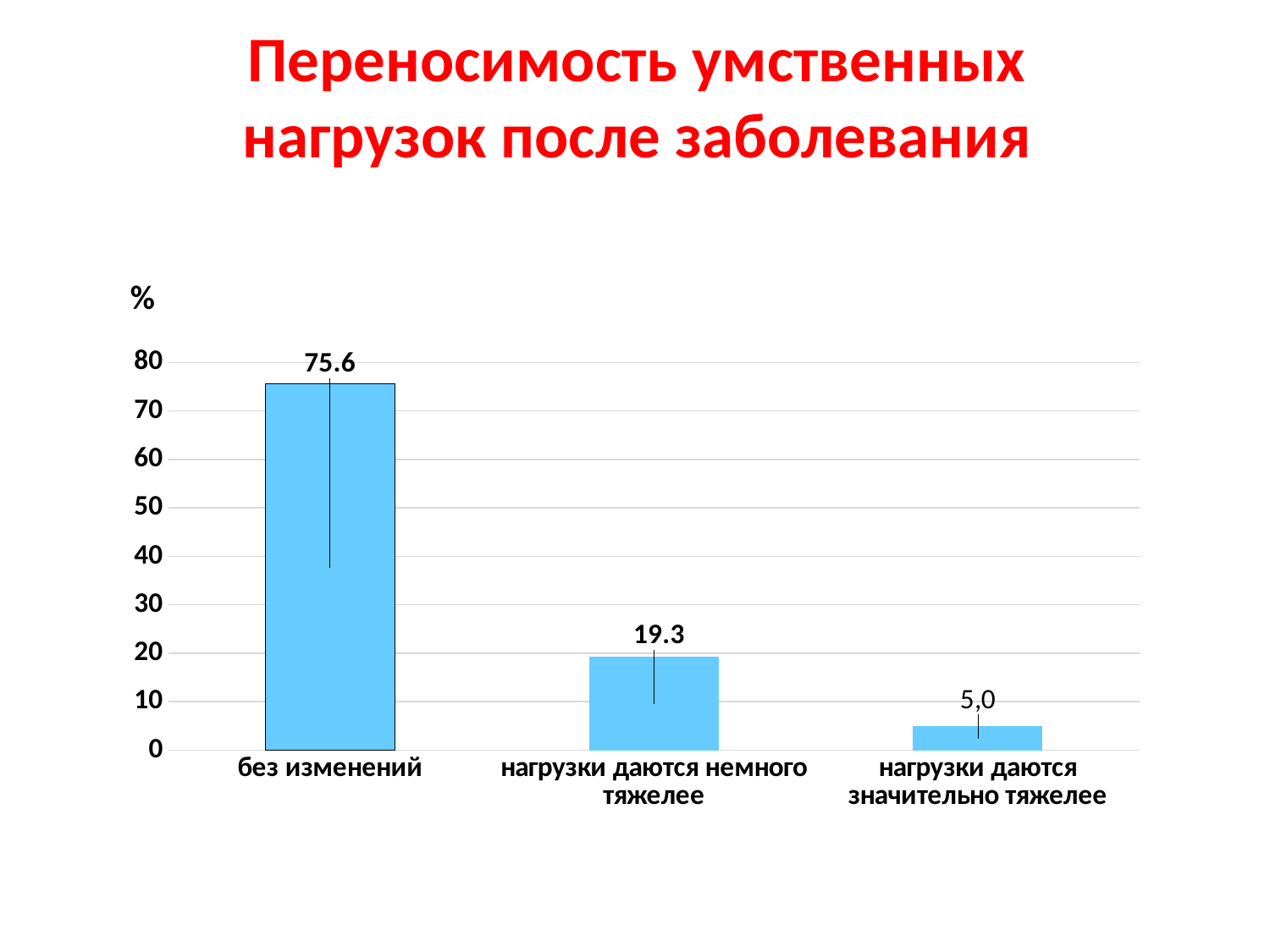
Which category has the lowest value? нагрузки даются значительно тяжелее What is the difference between the values for "без изменений" and "нагрузки даются немного тяжелее"? 56.3 What kind of chart is shown on the slide? bar chart How many categories are shown on the chart? 3 What is the value for "нагрузки даются немного тяжелее"? 19.3 Which is larger: the value for "нагрузки даются немного тяжелее" or for "нагрузки даются значительно тяжелее"? нагрузки даются немного тяжелее What is the value for "без изменений"? 75.6 What is the title of the slide? Переносимость умственных нагрузок после заболевания What is the value for "нагрузки даются значительно тяжелее"? 5,0 Is the value for "нагрузки даются немного тяжелее" greater or less than 30? less Which category has the highest value? без изменений Is the value for "без изменений" greater or less than 70? greater